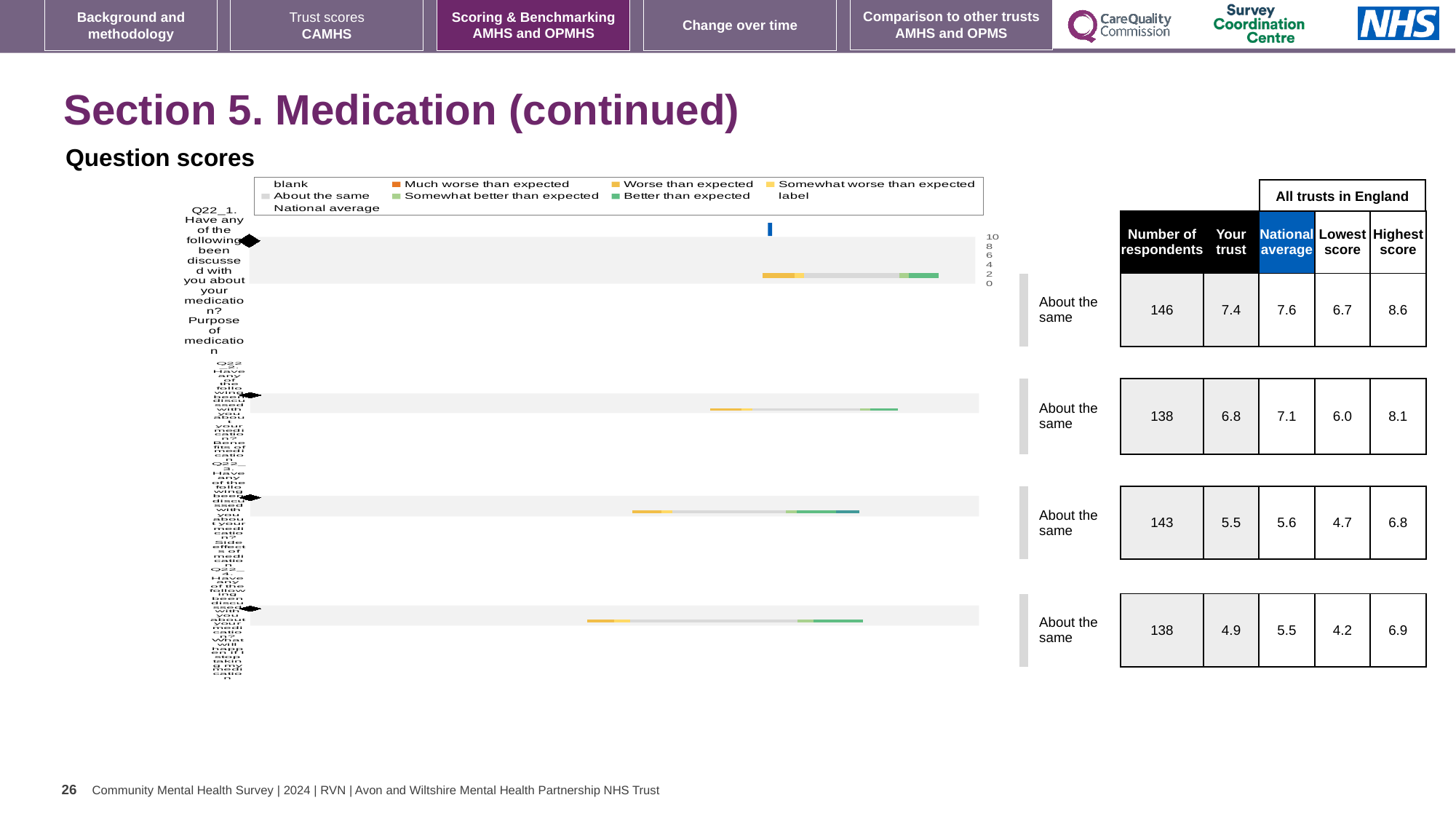
How many questions (bars) are plotted in the question scores chart? 4 What is the 'Your trust' score for Q22_1 (Purpose of medication)? 7.4 What kind of chart is used to show the question scores on this slide? bar chart Which question has the highest 'Your trust' score? Q22_1 Purpose of medication For Q22_1 (Purpose of medication), which is larger: the 'Your trust' score or the national average? National average What is the difference between the national average and the 'Your trust' score for Q22_2 (Benefits of medication)? 0.3 What is the highest score across all trusts in England for Q22_4? 6.9 Which question has the lowest 'Your trust' score? Q22_4 What will happen if I stop taking my medication How many respondents are listed for Q22_3 (Side effects of medication)? 143 What benchmark category is shown for all four questions? About the same What colour does the legend use for 'Much worse than expected'? orange What is the highest tick value shown on the chart's score axis? 10